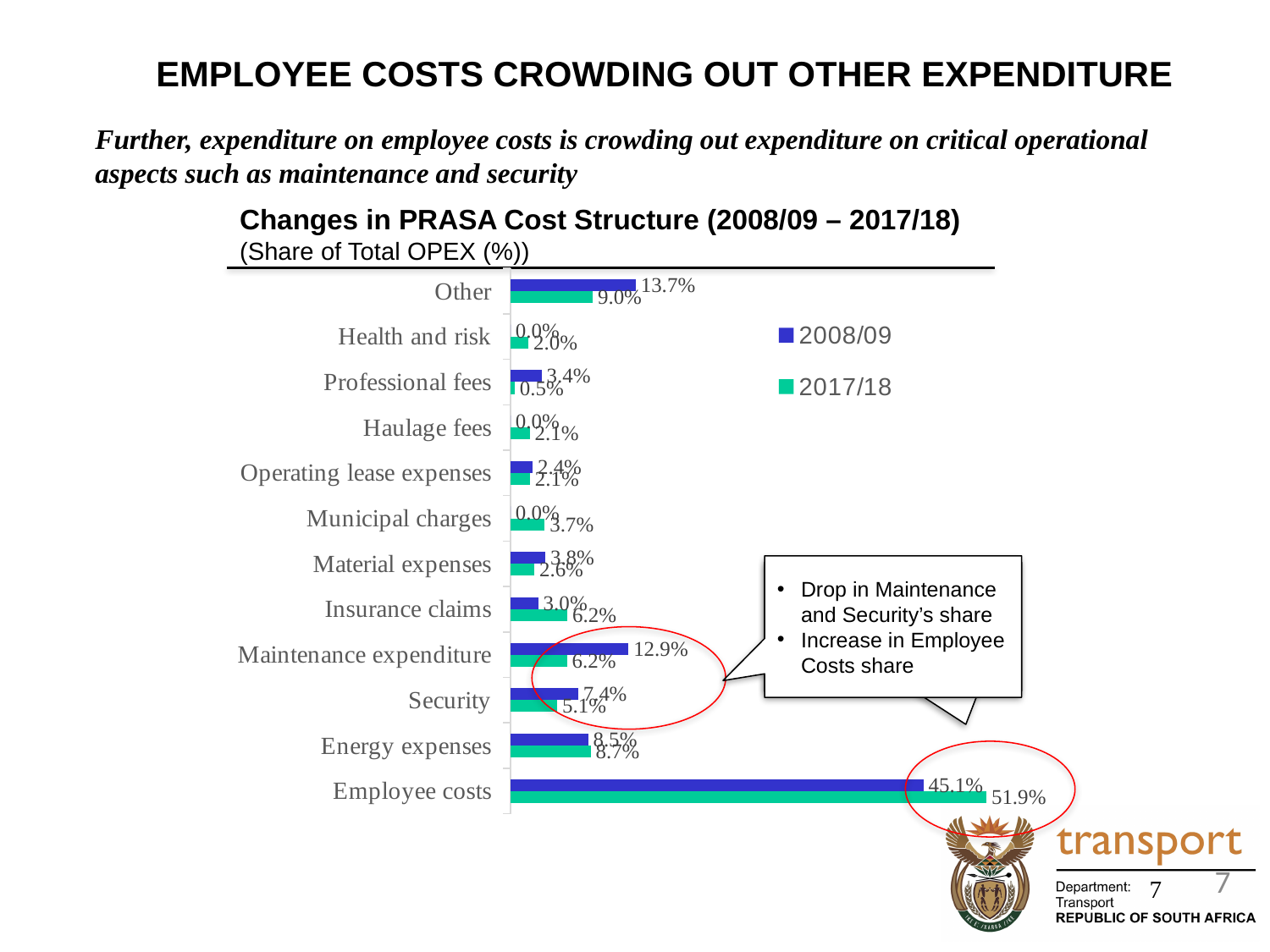
Which category has the highest share of total OPEX in 2017/18? Employee costs What is the 2008/09 value for Other? 13.7% What kind of chart is shown on the slide? Bar chart For Insurance claims, which year has the larger share: 2008/09 or 2017/18? 2017/18 What is the 2017/18 share of total OPEX for Employee costs? 51.9% What is the 2008/09 share of total OPEX for Maintenance expenditure? 12.9% How many cost categories are plotted in the chart? 12 For Security, which year has the larger share: 2008/09 or 2017/18? 2008/09 How many series does the legend list? 2 What is the difference between the 2008/09 and 2017/18 shares for Maintenance expenditure? 6.7% What is the title of the chart? Changes in PRASA Cost Structure (2008/09 – 2017/18) What is the difference between the 2017/18 and 2008/09 shares for Employee costs? 6.8%